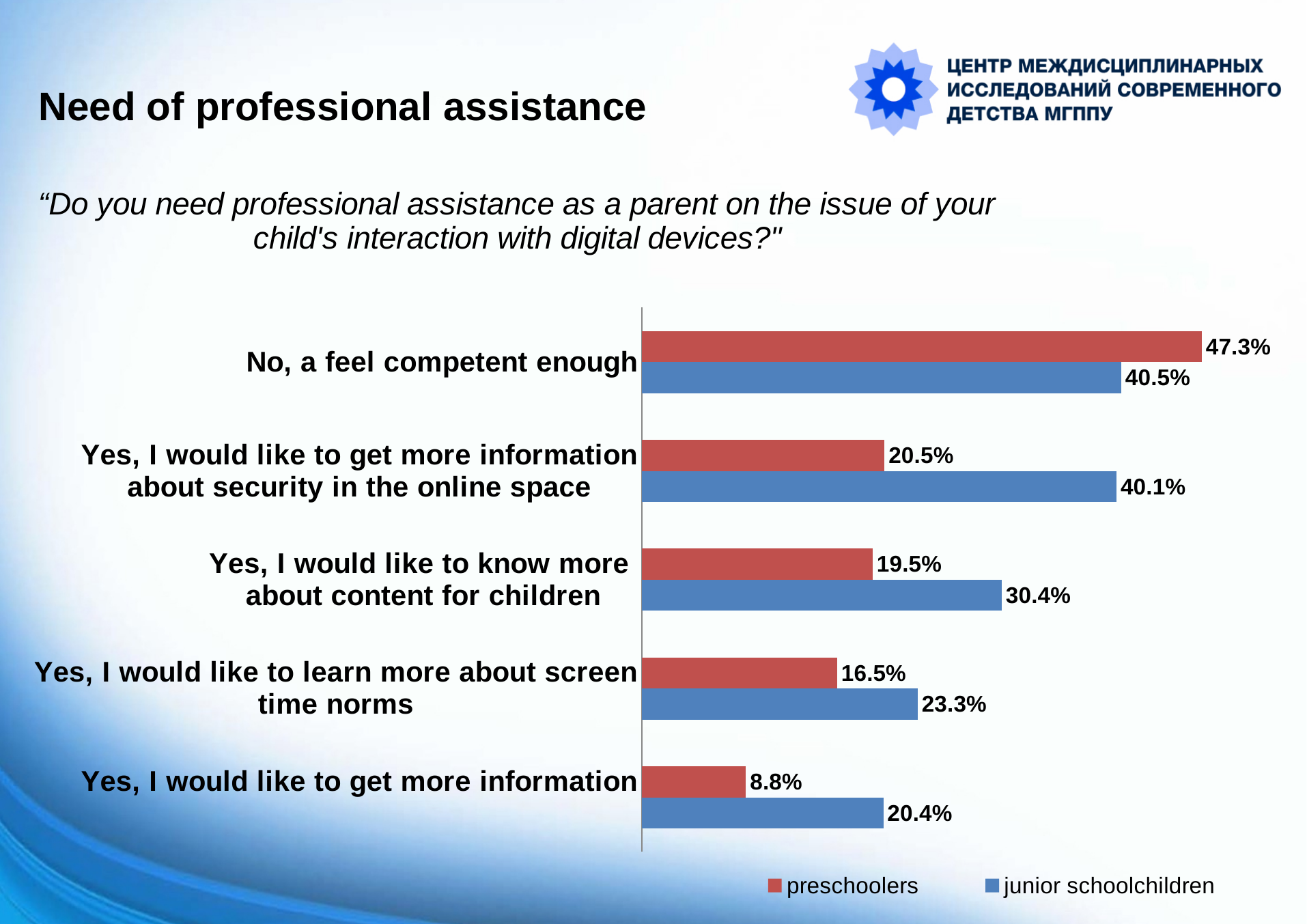
How many series does the legend list? 2 What percentage of preschoolers' parents answered "No, a feel competent enough"? 47.3% What is the preschoolers value for "Yes, I would like to learn more about screen time norms"? 16.5% What is the value for junior schoolchildren for "Yes, I would like to get more information about security in the online space"? 40.1% For "Yes, I would like to get more information", which group has the larger value? junior schoolchildren Which category has the highest value for junior schoolchildren? No, a feel competent enough What type of chart is shown on the slide? bar chart For "No, a feel competent enough", which group has the larger value, preschoolers or junior schoolchildren? preschoolers How many response categories are shown in the chart? 5 What is the difference between the junior schoolchildren and preschoolers values for "Yes, I would like to know more about content for children"? 10.9% Which category has the lowest value for preschoolers? Yes, I would like to get more information Which colour represents junior schoolchildren in the chart? blue